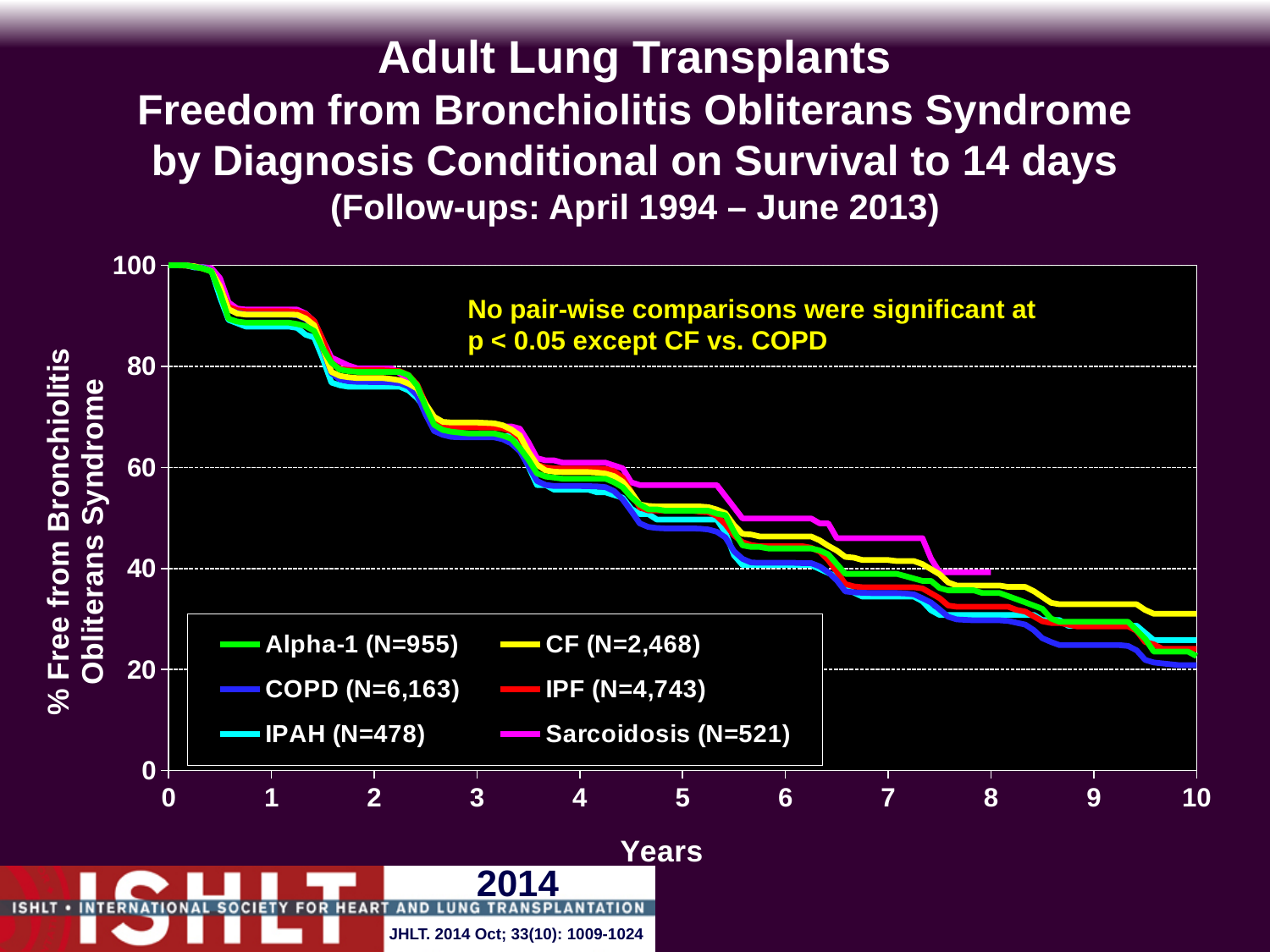
According to the legend, what is the N for COPD? N=6,163 Which diagnosis group has the lowest value at year 10? COPD Is the value for Sarcoidosis at year 5 greater or less than 40? greater Is the value for COPD at year 8 greater or less than 40? less Is the value for CF at year 10 greater or less than 20? greater Which diagnosis group has the highest value at year 10? CF Do the values rise or fall as the years increase along the x axis? fall What kind of chart is shown on the slide? line chart What is the value for all diagnosis groups at year 0? 100 How many series does the legend list? 6 At year 10, which is larger, the value for CF or the value for COPD? CF